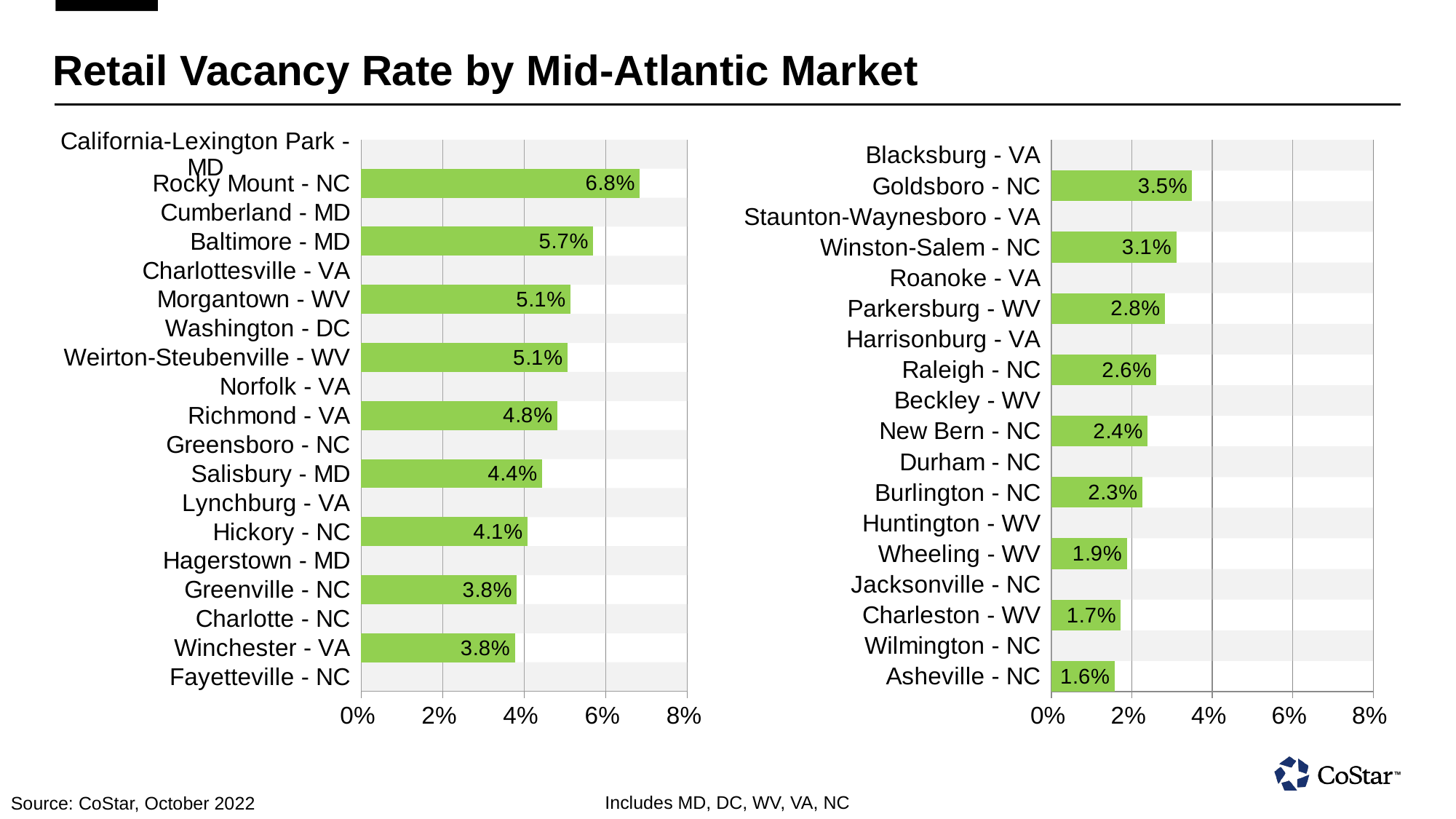
In the right chart, which market has the lowest retail vacancy rate? Asheville - NC In the left chart, which market has the highest retail vacancy rate? Rocky Mount - NC In the right chart, which has a higher vacancy rate, Raleigh - NC or Burlington - NC? Raleigh - NC In the left chart, what is the retail vacancy rate for Rocky Mount - NC? 6.8% In the right chart, what is the retail vacancy rate for Wheeling - WV? 1.9% What is the title of the slide? Retail Vacancy Rate by Mid-Atlantic Market In the left chart, what is the retail vacancy rate for Baltimore - MD? 5.7% In the right chart, which market has the highest retail vacancy rate? Goldsboro - NC In the left chart, what is the difference in vacancy rate between Rocky Mount - NC and Baltimore - MD? 1.1 percentage points What kind of chart is used on this slide? Bar chart In the right chart, what is the retail vacancy rate for Parkersburg - WV? 2.8% In the left chart, is the vacancy rate for Morgantown - WV greater or less than 4%? greater